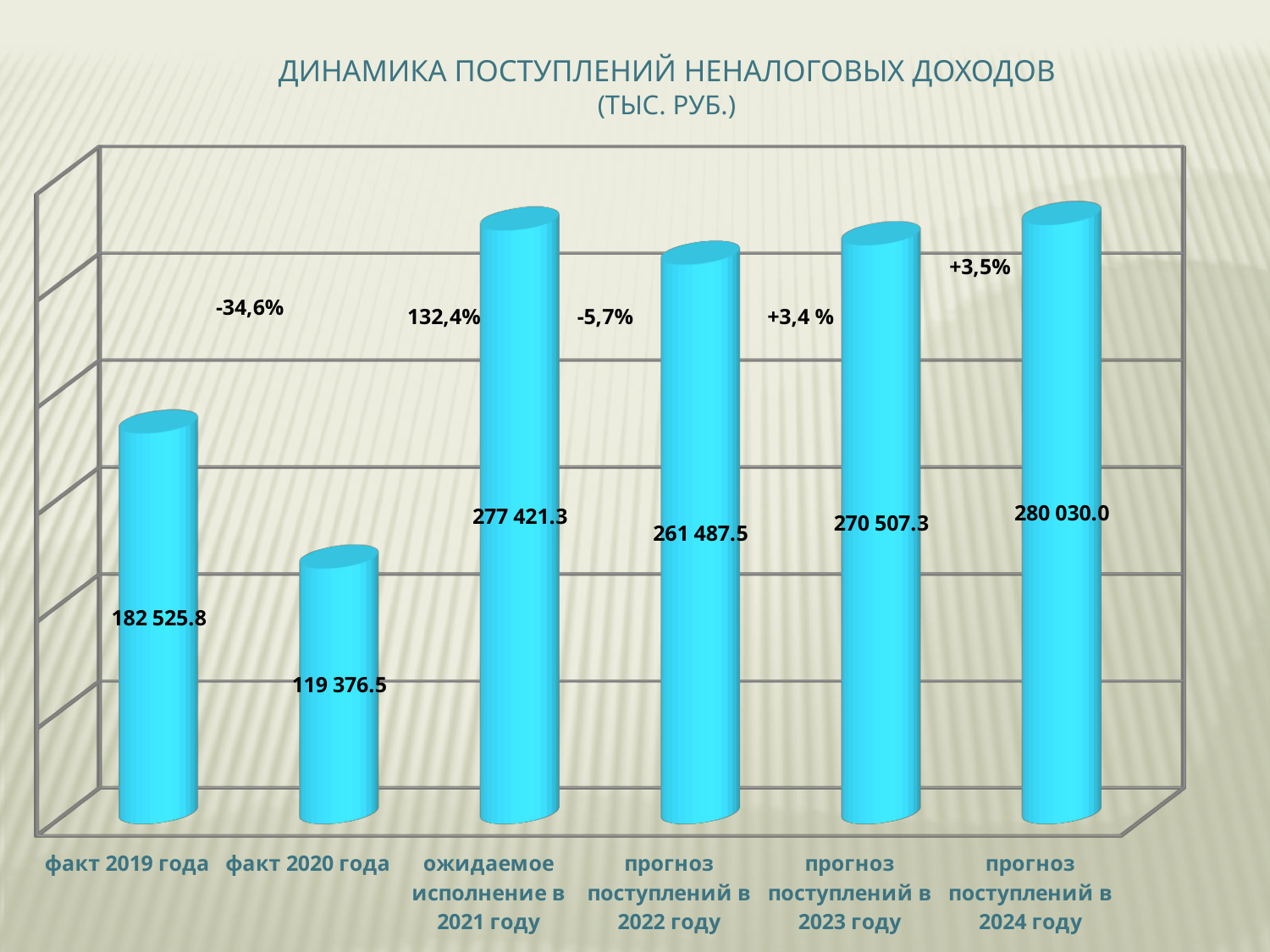
How many categories are shown on the chart? 6 Which category has the lowest value? факт 2020 года What is the value for факт 2020 года? 119 376.5 Which is larger: the value for ожидаемое исполнение в 2021 году or the value for прогноз поступлений в 2022 году? ожидаемое исполнение в 2021 году Do the values rise or fall from прогноз поступлений в 2022 году to прогноз поступлений в 2024 году? rise What is the value for прогноз поступлений в 2024 году? 280 030.0 What is the difference between the values for факт 2019 года and факт 2020 года? 63 149.3 Which category has the highest value? прогноз поступлений в 2024 году What is the value for факт 2019 года? 182 525.8 What is the difference between the values for прогноз поступлений в 2024 году and прогноз поступлений в 2023 году? 9 522.7 What is the value for ожидаемое исполнение в 2021 году? 277 421.3 What kind of chart is shown on the slide? bar chart